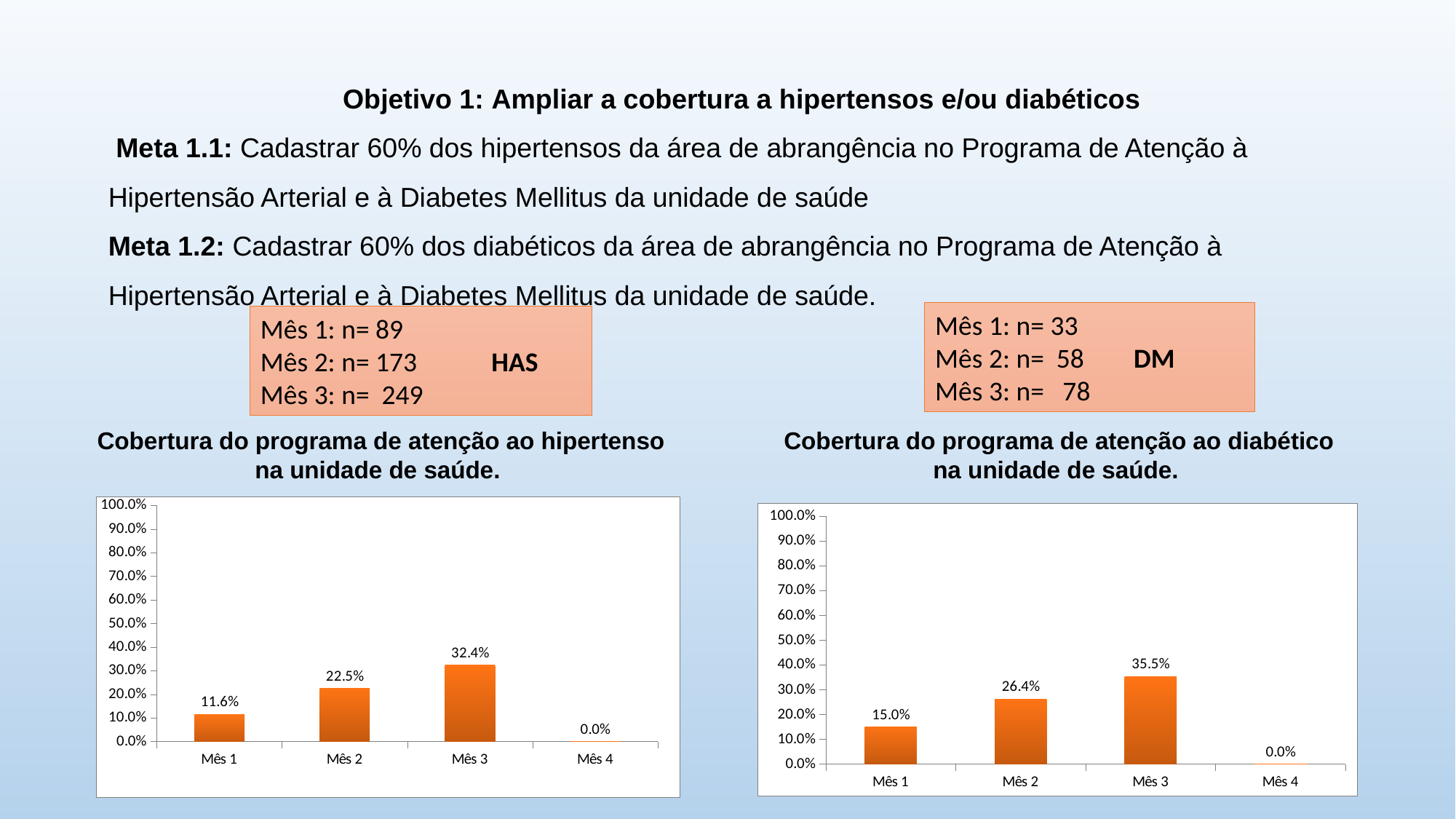
In the chart 'Cobertura do programa de atenção ao hipertenso na unidade de saúde', which month has the highest value? Mês 3 Which is larger: the Mês 3 value in the hipertenso chart (left) or the Mês 3 value in the diabético chart (right)? The diabético chart (35.5%) What kind of chart is 'Cobertura do programa de atenção ao hipertenso na unidade de saúde'? Bar chart What is the value for Mês 4 in the chart 'Cobertura do programa de atenção ao hipertenso na unidade de saúde'? 0.0% In the chart 'Cobertura do programa de atenção ao hipertenso na unidade de saúde', what is the difference between the values for Mês 3 and Mês 1? 20.8% In the chart 'Cobertura do programa de atenção ao diabético na unidade de saúde', what is the difference between the values for Mês 2 and Mês 1? 11.4% In the chart 'Cobertura do programa de atenção ao hipertenso na unidade de saúde', is the value for Mês 3 greater or less than 40.0%? less In the chart 'Cobertura do programa de atenção ao diabético na unidade de saúde', what is the value for Mês 3? 35.5% In the chart 'Cobertura do programa de atenção ao hipertenso na unidade de saúde', what is the value for Mês 2? 22.5% In the chart 'Cobertura do programa de atenção ao diabético na unidade de saúde', do the values rise or fall from Mês 1 to Mês 3? Rise In the chart 'Cobertura do programa de atenção ao diabético na unidade de saúde', which month has the lowest value? Mês 4 How many months are shown on the x axis of the chart 'Cobertura do programa de atenção ao diabético na unidade de saúde'? 4